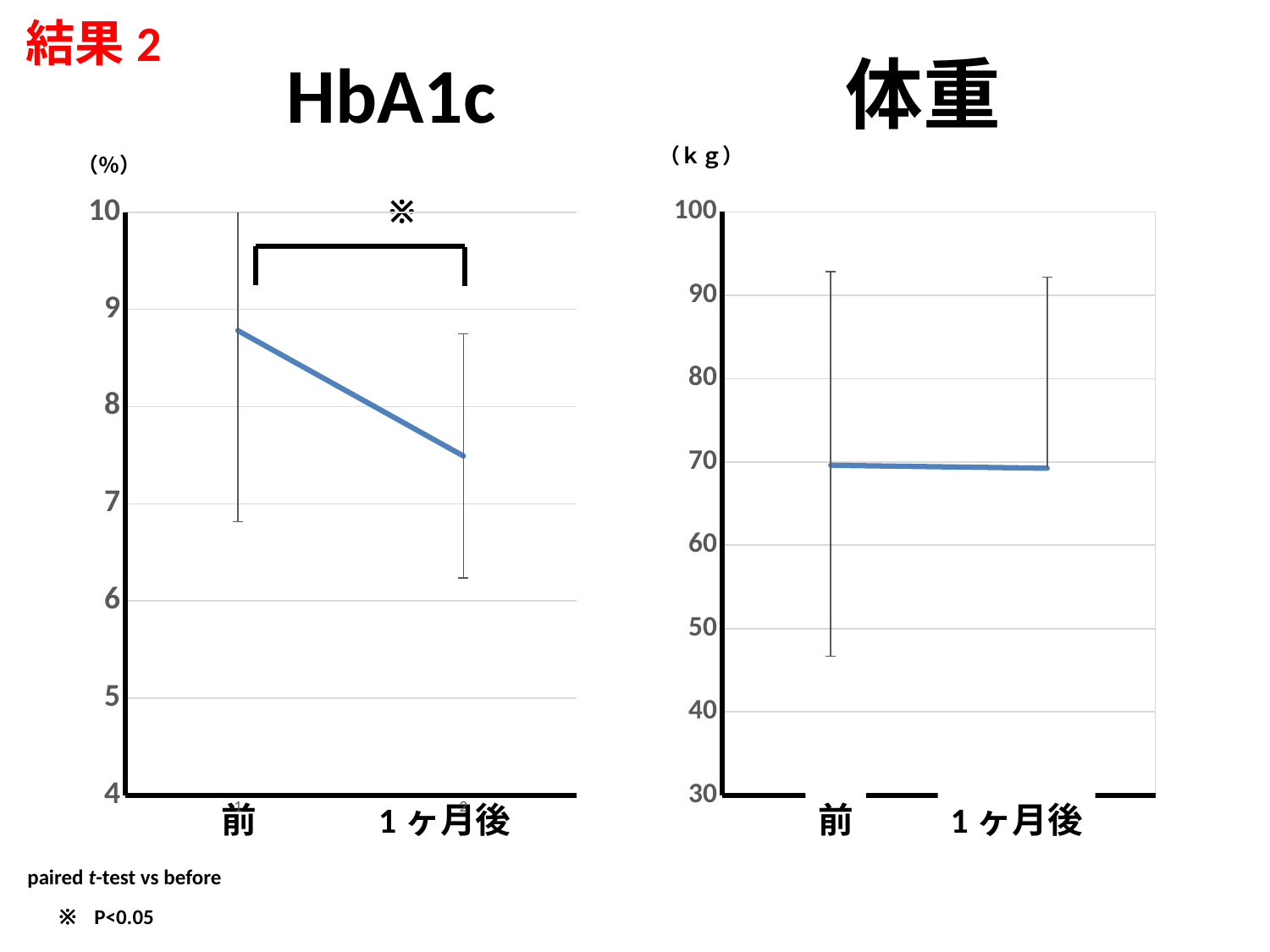
What unit is shown on the y axis of the 体重 chart? kg What unit is shown on the y axis of the HbA1c chart? % In the 体重 chart, is the value for 前 greater or less than 60? greater In the HbA1c chart, does the value rise or fall from 前 to 1ヶ月後? fall How many categories are shown on the x axis of the 体重 chart? 2 How many categories are shown on the x axis of the HbA1c chart? 2 What kind of chart is the HbA1c chart? line chart In the HbA1c chart, which is larger, the value for 前 or the value for 1ヶ月後? 前 In the HbA1c chart, is the value for 前 greater or less than 8? greater What kind of chart is the 体重 chart? line chart In the 体重 chart, is the value for 1ヶ月後 greater or less than 80? less